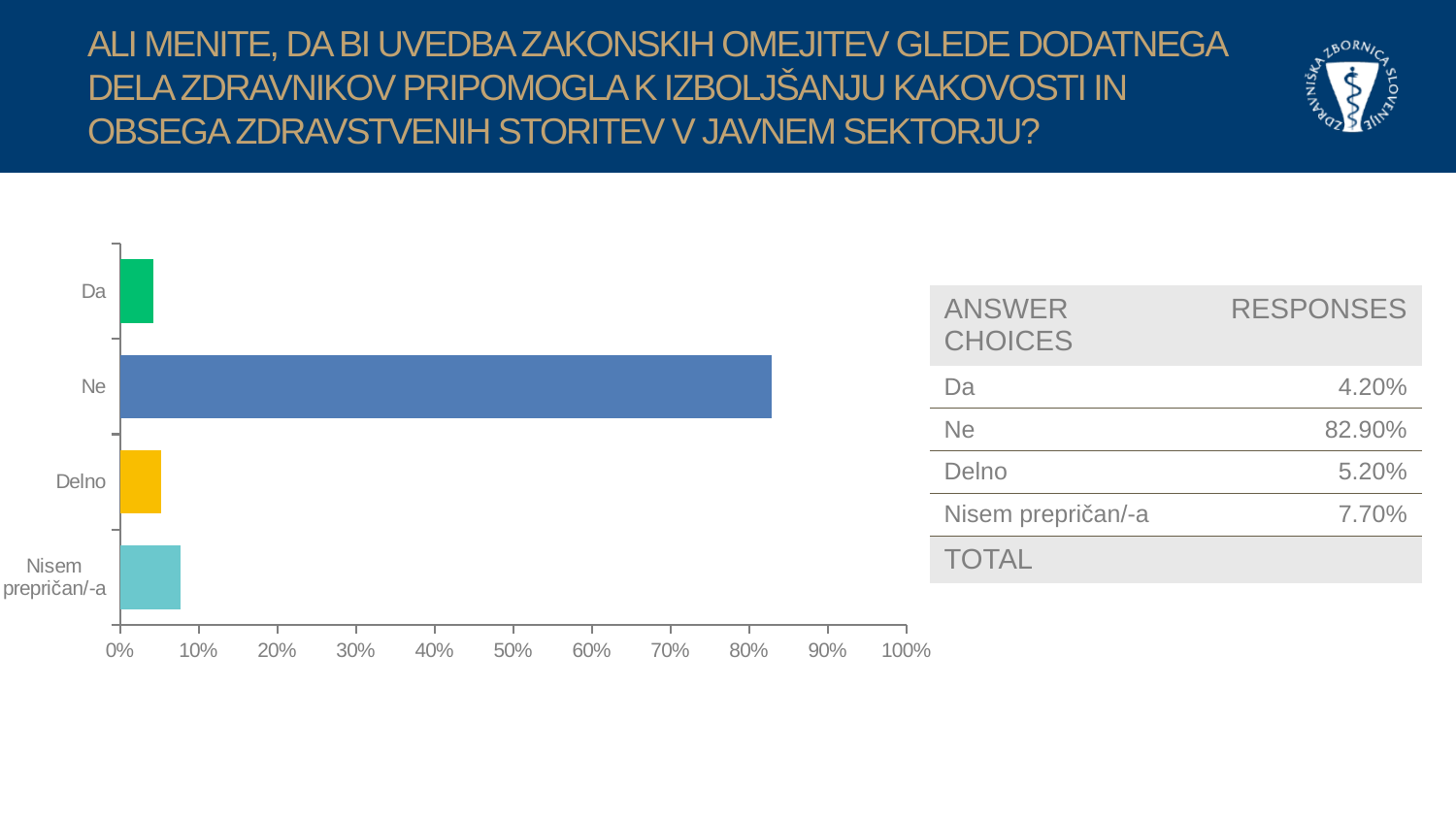
What colour is the bar for "Ne"? blue What is the value for "Delno"? 5.20% How many categories does the bar chart show? 4 What kind of chart is shown on the slide? bar chart Which is larger, the value for "Delno" or the value for "Nisem prepričan/-a"? Nisem prepričan/-a Which category has the lowest value? Da What is the difference between the values for "Ne" and "Nisem prepričan/-a"? 75.20% What is the value for "Da"? 4.20% Which category has the highest value? Ne What is the value for "Ne"? 82.90% Is the value for "Ne" greater or less than 80%? greater What is the value for "Nisem prepričan/-a"? 7.70%